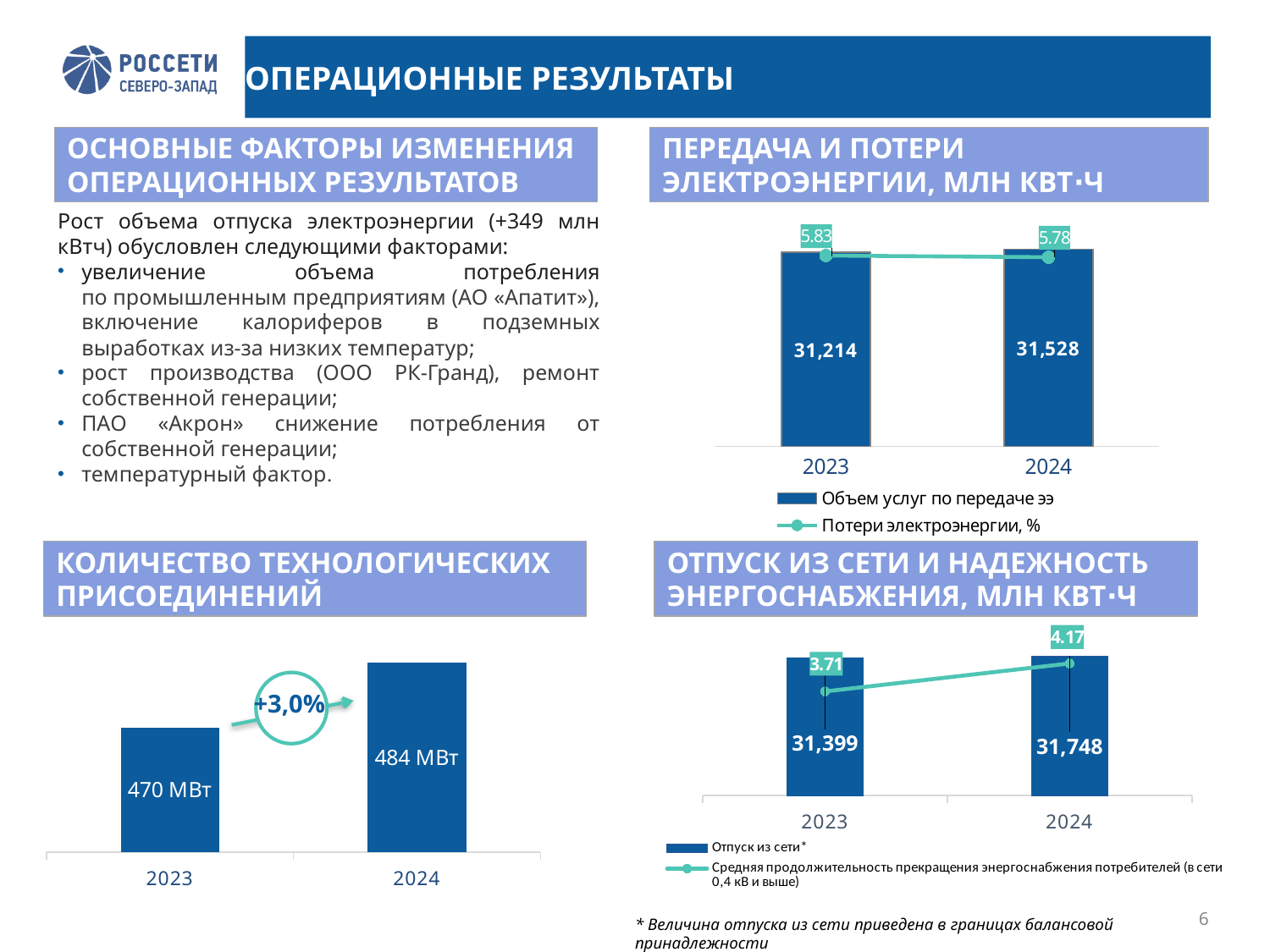
In the chart 'КОЛИЧЕСТВО ТЕХНОЛОГИЧЕСКИХ ПРИСОЕДИНЕНИЙ', what is the value for 2023? 470 МВт In the chart 'КОЛИЧЕСТВО ТЕХНОЛОГИЧЕСКИХ ПРИСОЕДИНЕНИЙ', what percentage change is shown between 2023 and 2024? +3,0% What kind of chart is 'КОЛИЧЕСТВО ТЕХНОЛОГИЧЕСКИХ ПРИСОЕДИНЕНИЙ'? bar chart In the chart 'ПЕРЕДАЧА И ПОТЕРИ ЭЛЕКТРОЭНЕРГИИ, МЛН КВТ·Ч', what is the value of 'Объем услуг по передаче ээ' for 2024? 31,528 In the chart 'ПЕРЕДАЧА И ПОТЕРИ ЭЛЕКТРОЭНЕРГИИ, МЛН КВТ·Ч', what is the difference between the 2024 and 2023 values of 'Объем услуг по передаче ээ'? 314 How many series does the legend of the chart 'ПЕРЕДАЧА И ПОТЕРИ ЭЛЕКТРОЭНЕРГИИ, МЛН КВТ·Ч' list? 2 In the chart 'ОТПУСК ИЗ СЕТИ И НАДЕЖНОСТЬ ЭНЕРГОСНАБЖЕНИЯ, МЛН КВТ·Ч', what is the difference between the 2024 and 2023 values of 'Отпуск из сети'? 349 In the chart 'ПЕРЕДАЧА И ПОТЕРИ ЭЛЕКТРОЭНЕРГИИ, МЛН КВТ·Ч', what is the value of 'Потери электроэнергии, %' for 2023? 5.83 In the chart 'ПЕРЕДАЧА И ПОТЕРИ ЭЛЕКТРОЭНЕРГИИ, МЛН КВТ·Ч', does 'Потери электроэнергии, %' rise or fall from 2023 to 2024? fall In the chart 'ОТПУСК ИЗ СЕТИ И НАДЕЖНОСТЬ ЭНЕРГОСНАБЖЕНИЯ, МЛН КВТ·Ч', what is the line value for 2024? 4.17 In the chart 'ОТПУСК ИЗ СЕТИ И НАДЕЖНОСТЬ ЭНЕРГОСНАБЖЕНИЯ, МЛН КВТ·Ч', what is the value of 'Отпуск из сети' for 2023? 31,399 In the chart 'КОЛИЧЕСТВО ТЕХНОЛОГИЧЕСКИХ ПРИСОЕДИНЕНИЙ', which year has the higher value? 2024